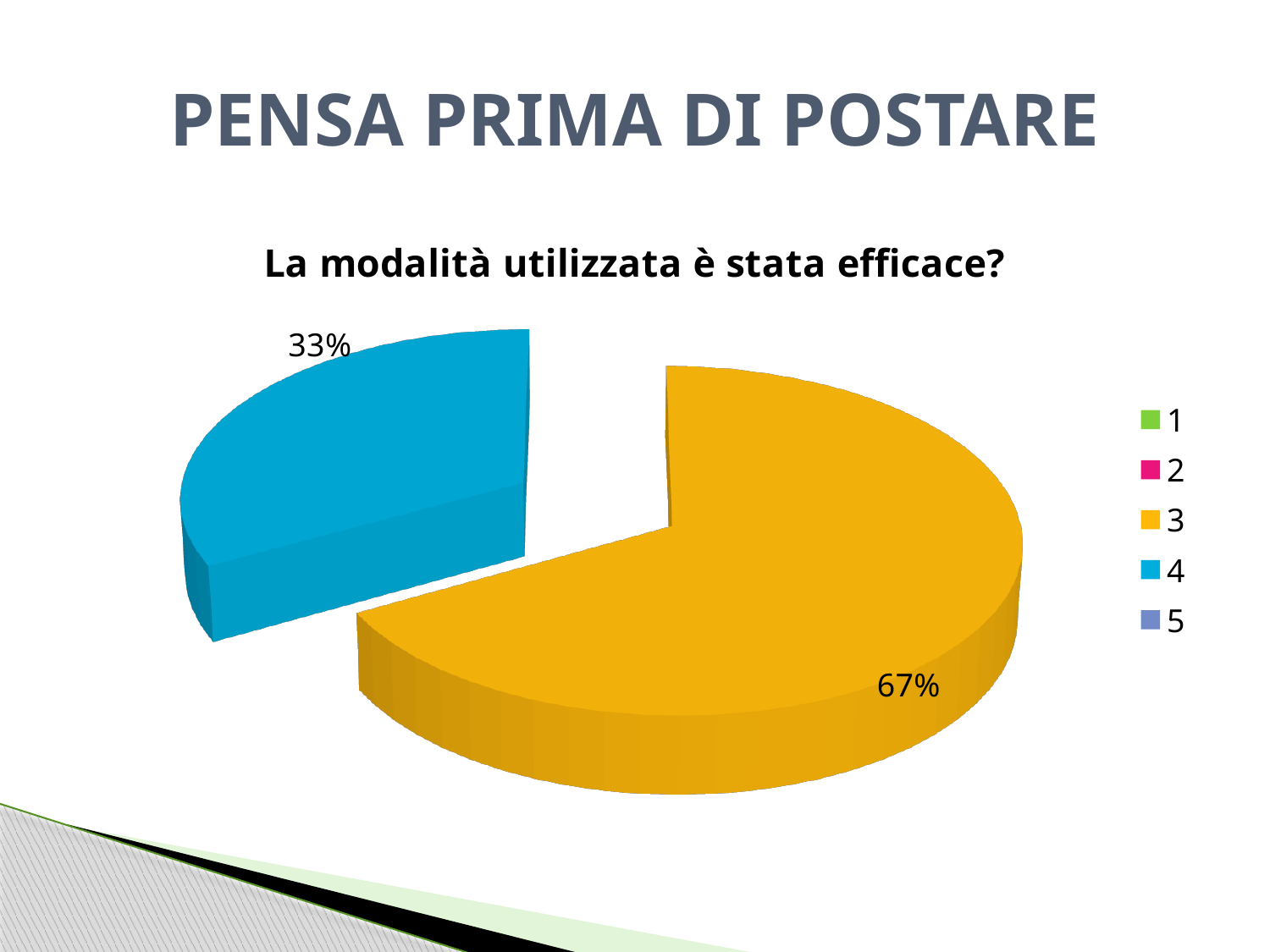
How many slices are visible in the pie? 2 What kind of chart is shown on the slide? Pie chart What share of the pie does category 3 represent? 67% How many entries does the legend list? 5 Is the share for category 4 greater or less than 50%? less Is the share for category 3 greater or less than 50%? greater What share of the pie does category 4 represent? 33% What is the difference in percentage points between the slice for category 3 and the slice for category 4? 34 Which category has the largest slice of the pie? 3 Which of the visible slices is smaller, category 3 or category 4? 4 What colour is the slice for category 4? Blue What is the title of the chart? La modalità utilizzata è stata efficace?